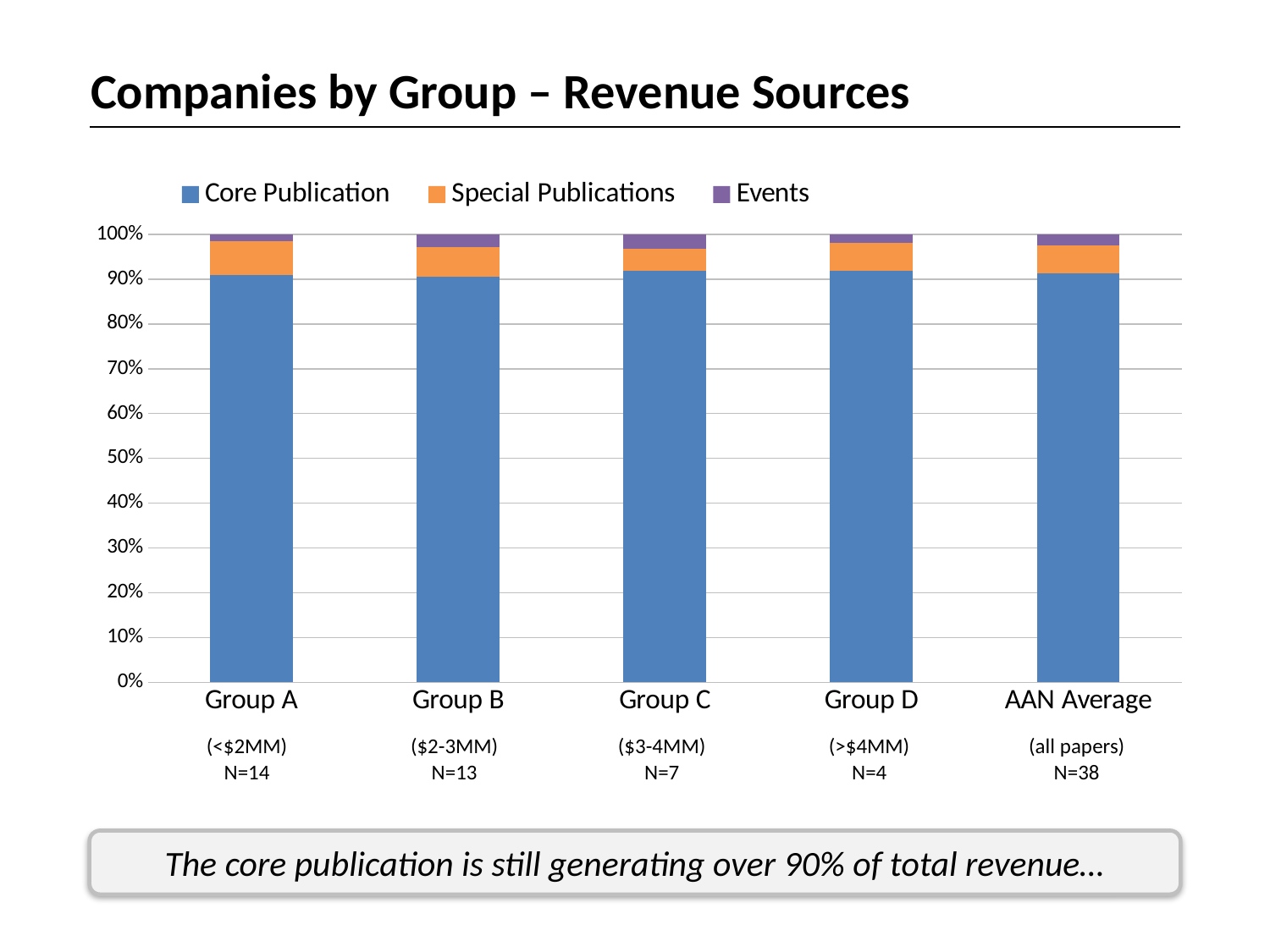
How many groups (categories) are plotted along the x axis? 5 What kind of chart is shown on the slide? Stacked bar chart Which group has the larger Events share, Group A or Group C? Group C Is the Core Publication share for Group C greater or less than 90%? greater Which series is shown in orange in the legend? Special Publications Is the Core Publication share for Group D greater or less than 90%? greater What does each stacked bar total? 100% Which group has the larger Special Publications share, Group A or Group C? Group A Is the Core Publication share for Group A greater or less than 80%? greater How many series does the legend list? 3 What is the title of the slide's chart? Companies by Group – Revenue Sources